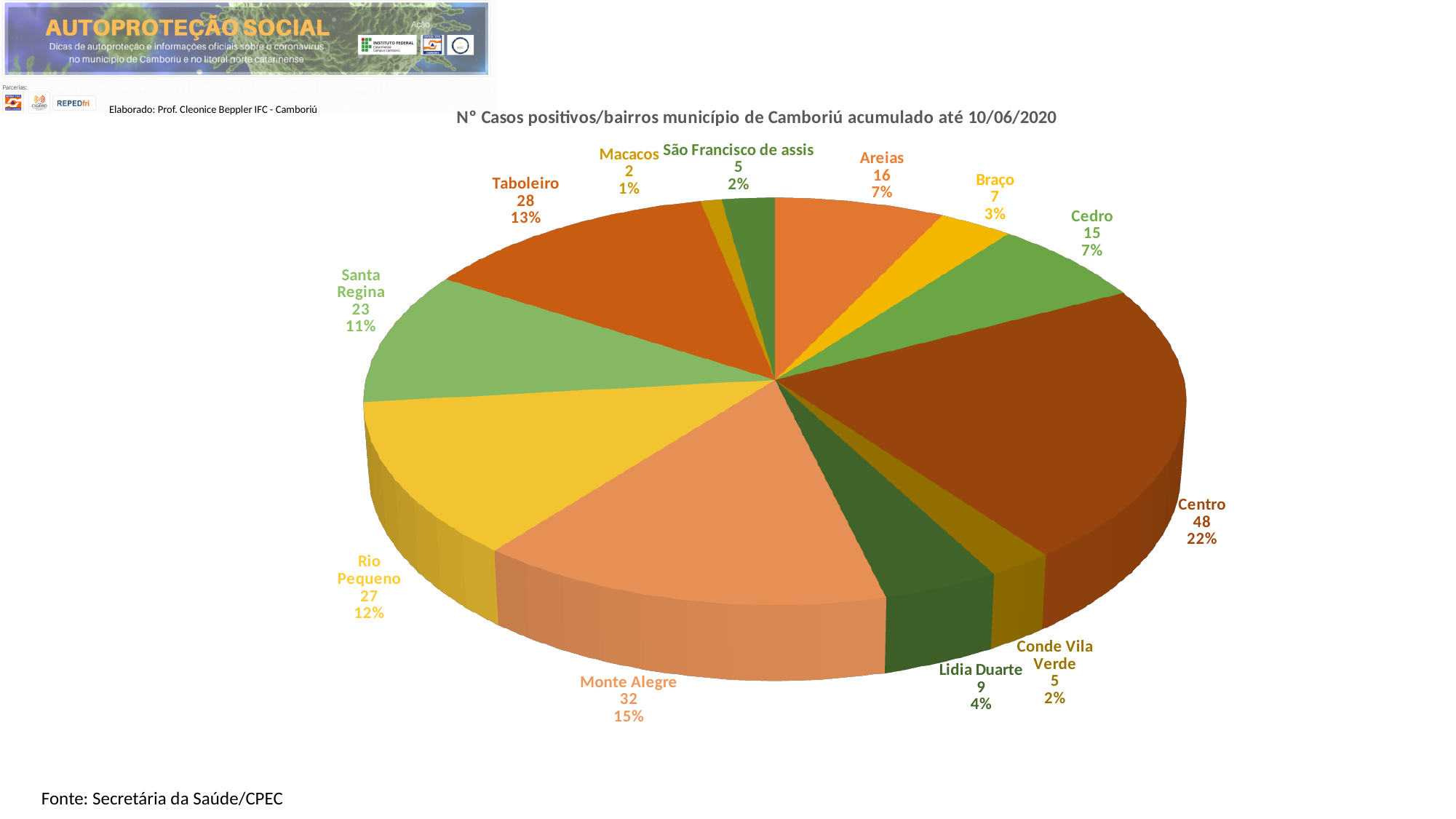
How many cases are shown for Centro? 48 What is the title of the chart? N° Casos positivos/bairros município de Camboriú acumulado até 10/06/2020 What percentage share does Lidia Duarte have? 4% How many cases are shown for Conde Vila Verde? 5 What percentage share does Monte Alegre have? 15% Which has more cases, Areias or Cedro? Areias How many bairros (slices) are shown in the pie chart? 12 How many cases are shown for Rio Pequeno? 27 What is the difference in cases between Taboleiro and Santa Regina? 5 Which bairro has the lowest number of cases? Macacos What kind of chart is shown on the slide? pie chart Which bairro has the highest number of cases? Centro